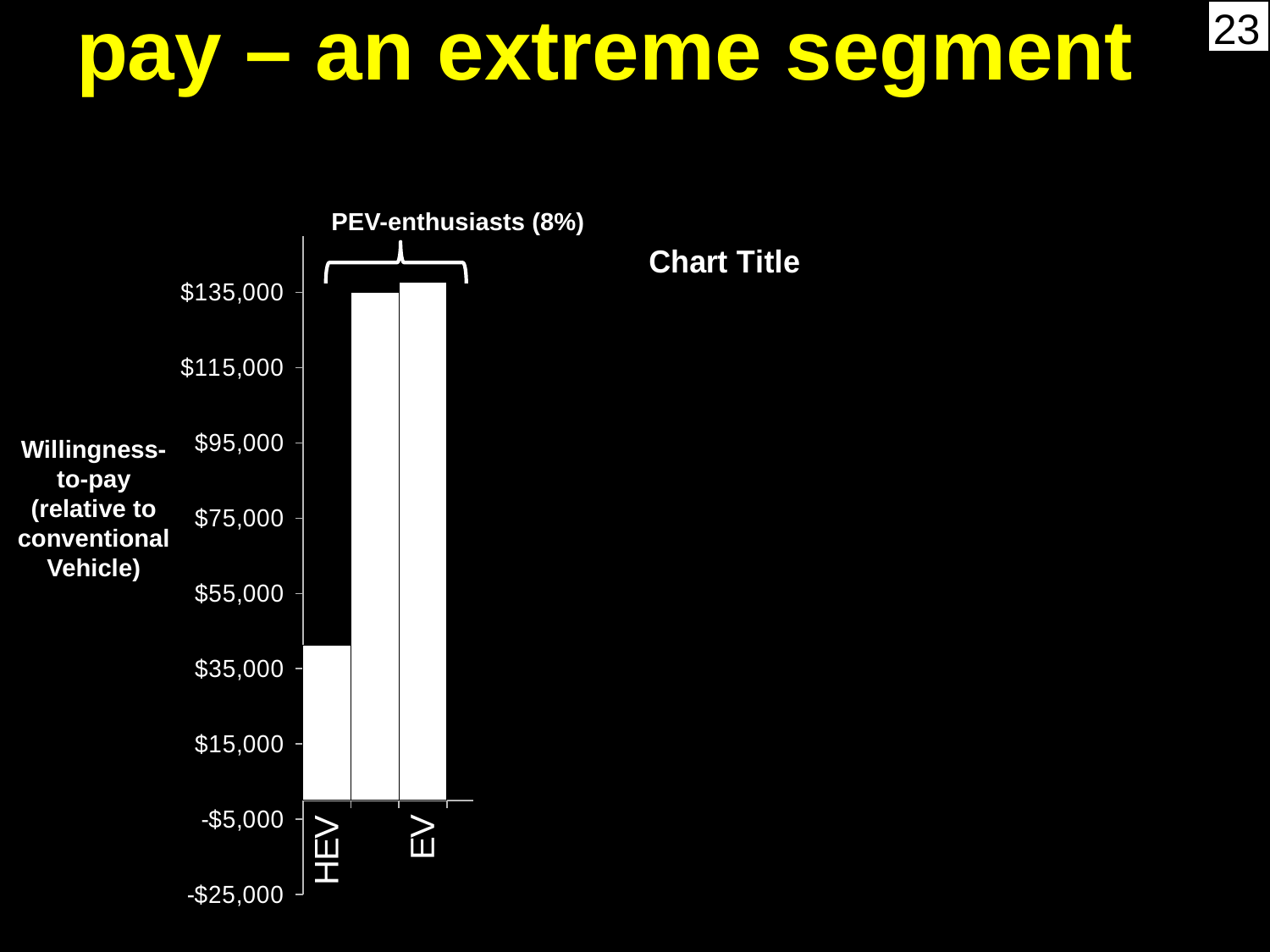
Which has the larger value, HEV or EV? EV Which bar has the lowest value in the chart? HEV Is the value for EV greater or less than $115,000? greater What is the highest value labelled on the vertical axis? $135,000 What kind of chart is shown on the slide? bar chart Is the value for EV greater or less than $95,000? greater What is the title shown on the chart? Chart Title Is the value for HEV greater or less than $35,000? greater What label is written above the bracket over the two tall bars? PEV-enthusiasts (8%) How many bars are plotted in the chart? 3